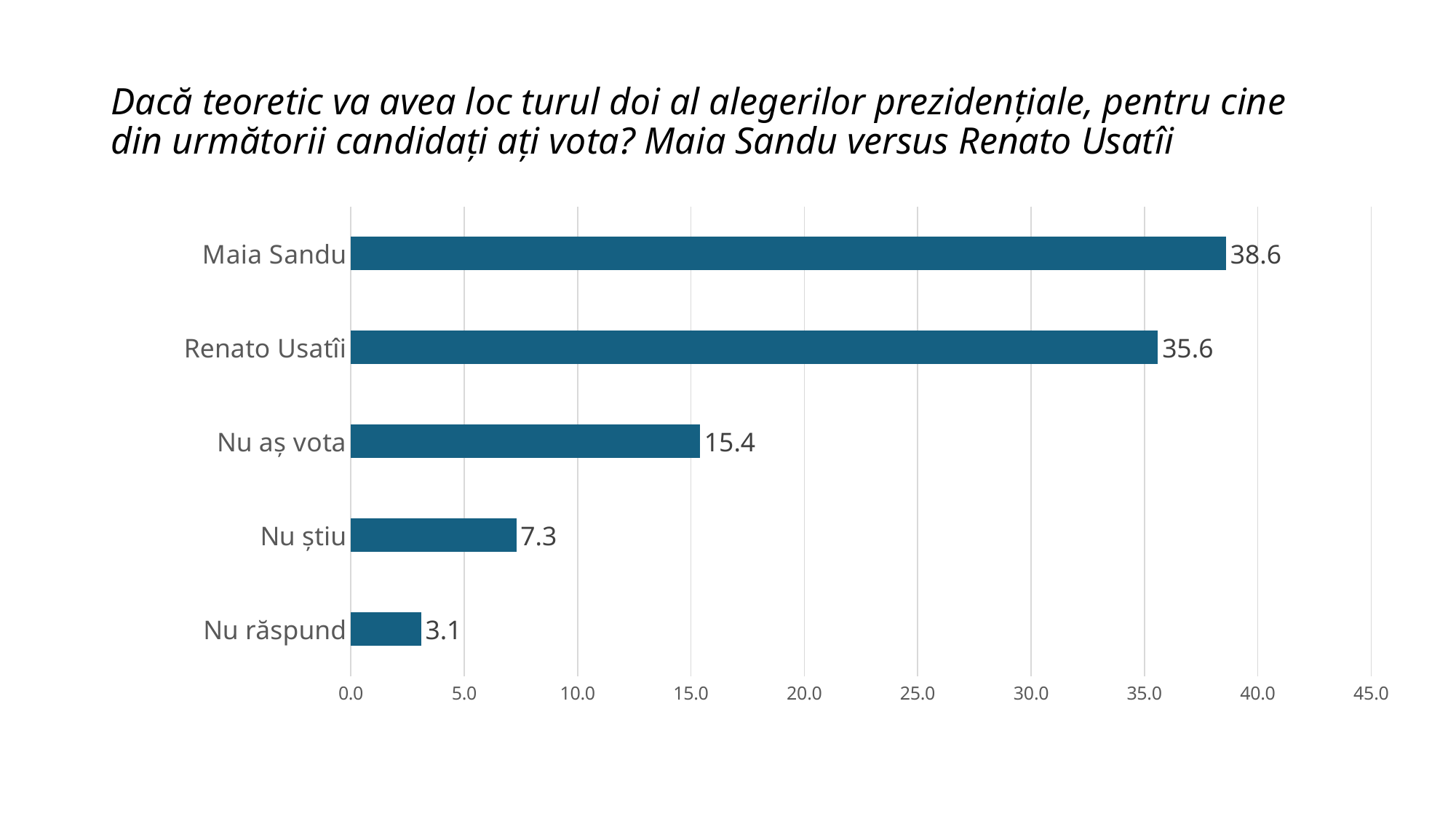
How many categories are shown in the chart? 5 What is the value for Renato Usatîi? 35.6 What is the value for Nu răspund? 3.1 What is the value for Maia Sandu? 38.6 What is the value for Nu aș vota? 15.4 What is the difference between the values for Maia Sandu and Renato Usatîi? 3.0 Which category has the lowest value? Nu răspund What is the highest tick value shown on the horizontal axis? 45.0 Which is larger, the value for Nu aș vota or the value for Nu știu? Nu aș vota Which category has the highest value? Maia Sandu What kind of chart is shown on the slide? bar chart Is the value for Nu știu greater or less than 10.0? less